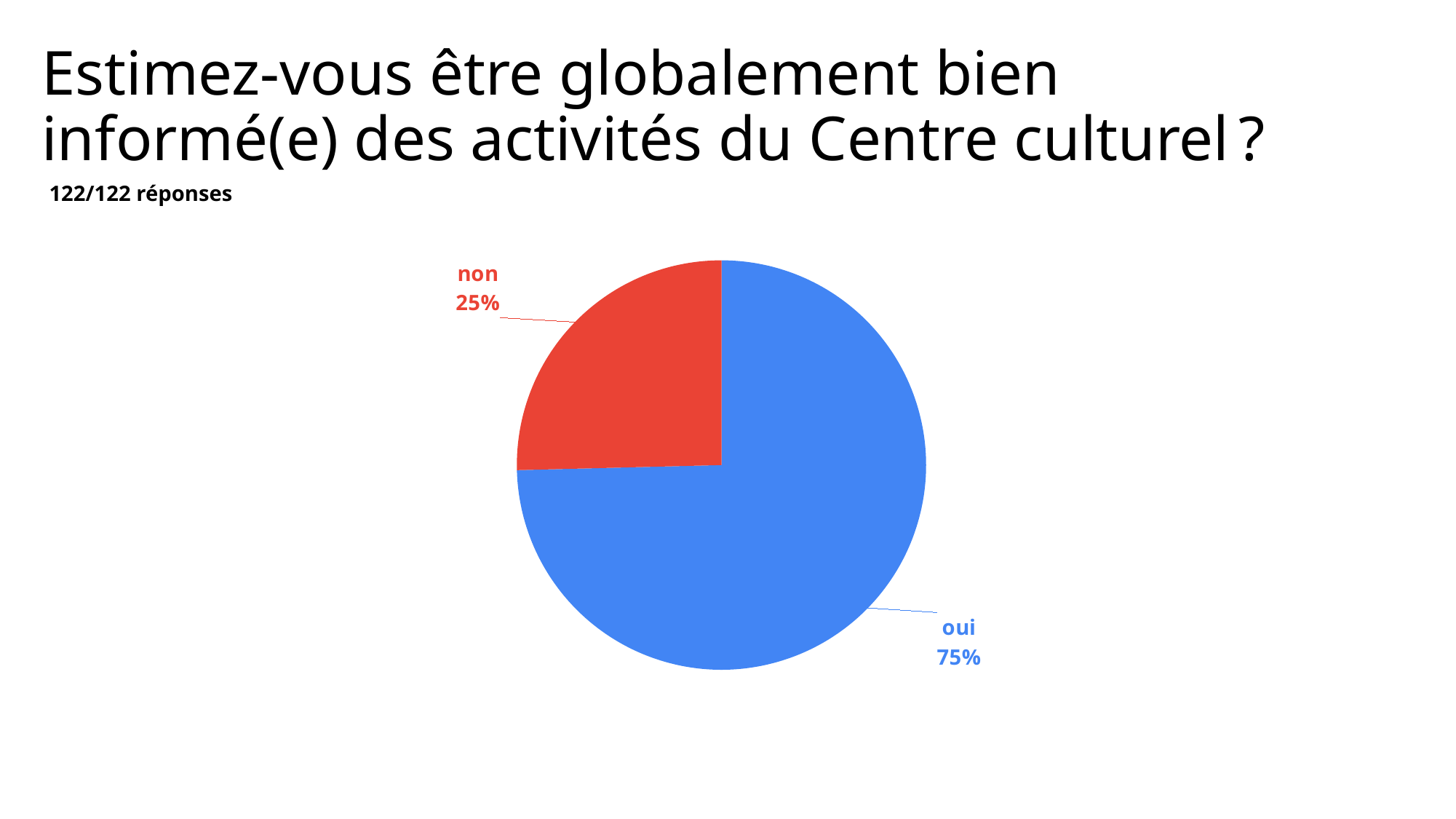
Which slice is the largest? oui What kind of chart is shown on the slide? pie chart What share of the pie is labelled "non"? 25% What colour is the "non" slice? red Which is larger, the "oui" slice or the "non" slice? oui How many responses does the slide say were collected? 122/122 réponses How many slices does the pie chart have? 2 What share of the pie is labelled "oui"? 75% What is the difference in percentage points between the "oui" and "non" slices? 50 Which slice is the smallest? non